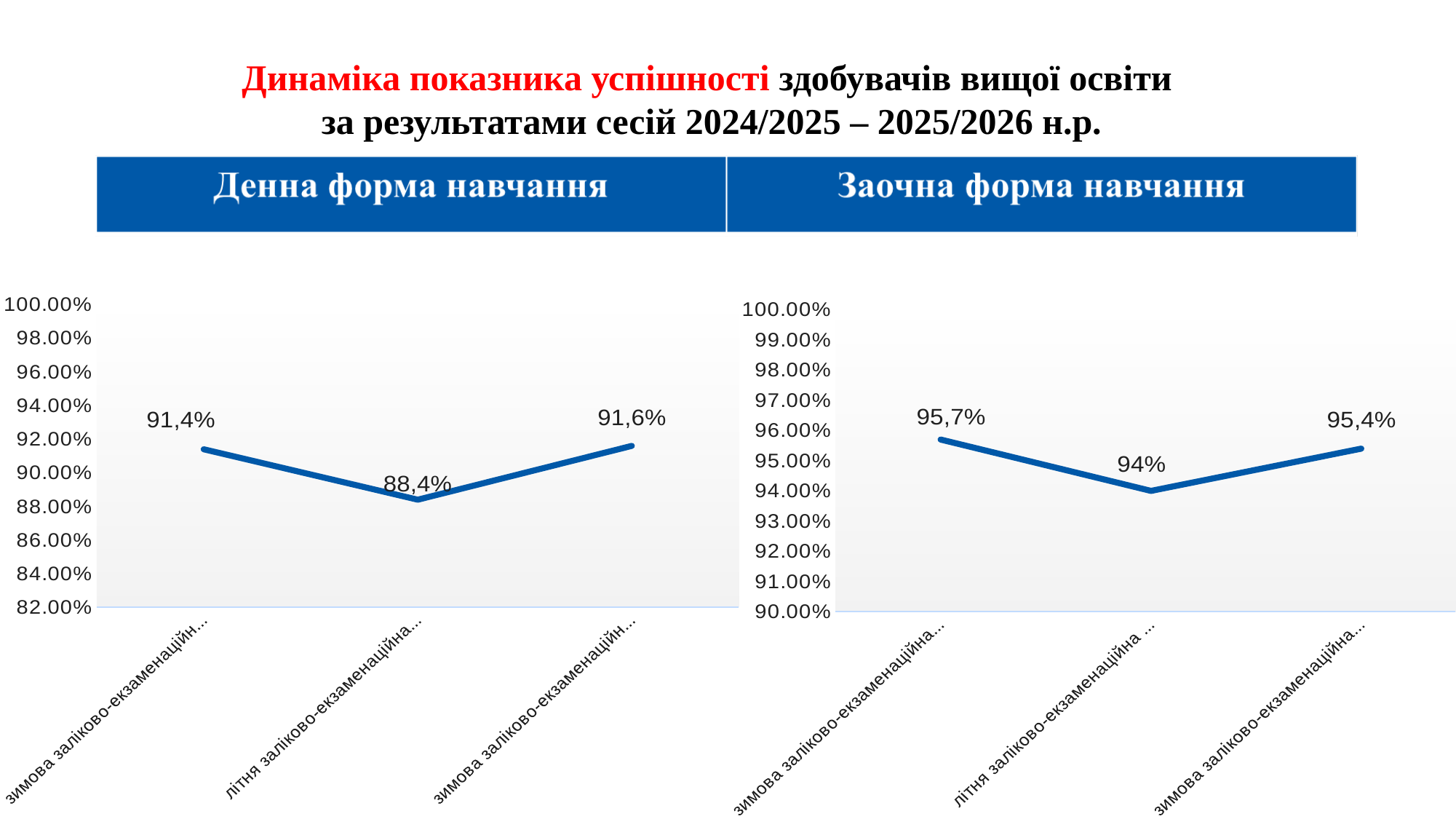
In the "Денна форма навчання" chart, what is the value for the last point? 91,6% In the "Денна форма навчання" chart, what is the difference between the first point (91,4%) and the middle point (88,4%)? 3 percentage points In the "Денна форма навчання" chart, what is the value for the first point? 91,4% In the "Заочна форма навчання" chart, what is the value for the first point? 95,7% In the "Заочна форма навчання" chart, what is the difference between the first point (95,7%) and the middle point (94%)? 1,7 percentage points In the "Денна форма навчання" chart, what is the value for the middle point (літня заліково-екзаменаційна session)? 88,4% In the "Заочна форма навчання" chart, what is the value for the middle point (літня заліково-екзаменаційна session)? 94% Which is larger: the last point in the "Денна форма навчання" chart or the last point in the "Заочна форма навчання" chart? Заочна форма навчання (95,4%) What kind of chart is shown under "Денна форма навчання"? line chart How many data points are plotted in the "Заочна форма навчання" chart? 3 In the "Заочна форма навчання" chart, which point has the lowest value? літня заліково-екзаменаційна (the middle point), 94% In the "Денна форма навчання" chart, which point has the highest value? the last point (зимова заліково-екзаменаційна), 91,6%